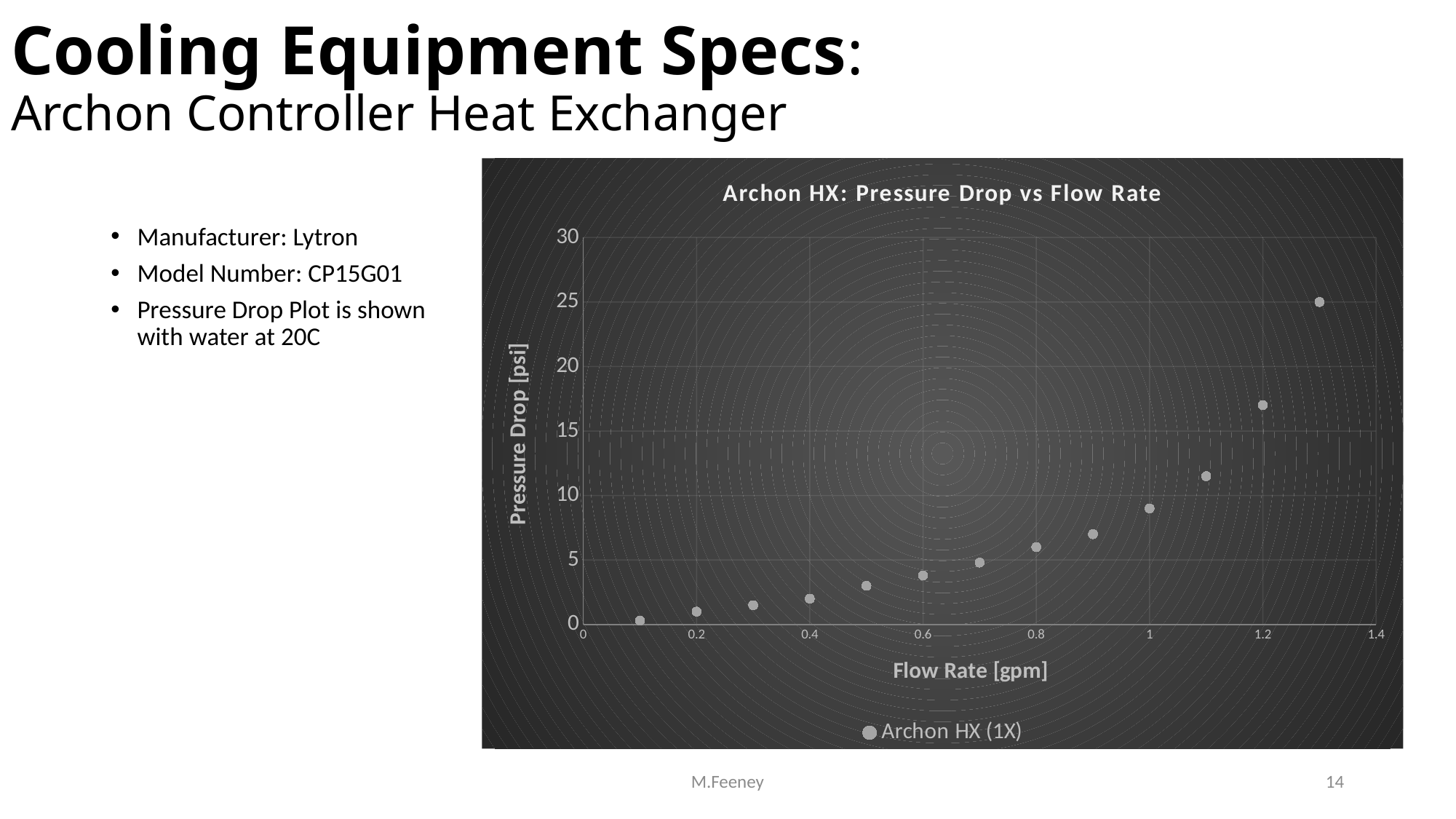
How many series does the chart legend list? 1 What is the name of the series in the chart legend? Archon HX (1X) What kind of chart is shown on the slide? scatter chart At which flow rate is the pressure drop lowest? 0.1 Do the pressure drop values rise or fall as flow rate increases along the x axis? rise Which has the larger pressure drop: the point at 0.8 gpm or the point at 1.1 gpm? 1.1 gpm What is the title of the chart? Archon HX: Pressure Drop vs Flow Rate How many data points are plotted in the chart? 13 At which flow rate is the pressure drop highest? 1.3 Is the pressure drop at a flow rate of 1.2 gpm greater or less than 15? greater Is the pressure drop at a flow rate of 0.5 gpm greater or less than 5? less Is the pressure drop at a flow rate of 1 gpm greater or less than 10? less